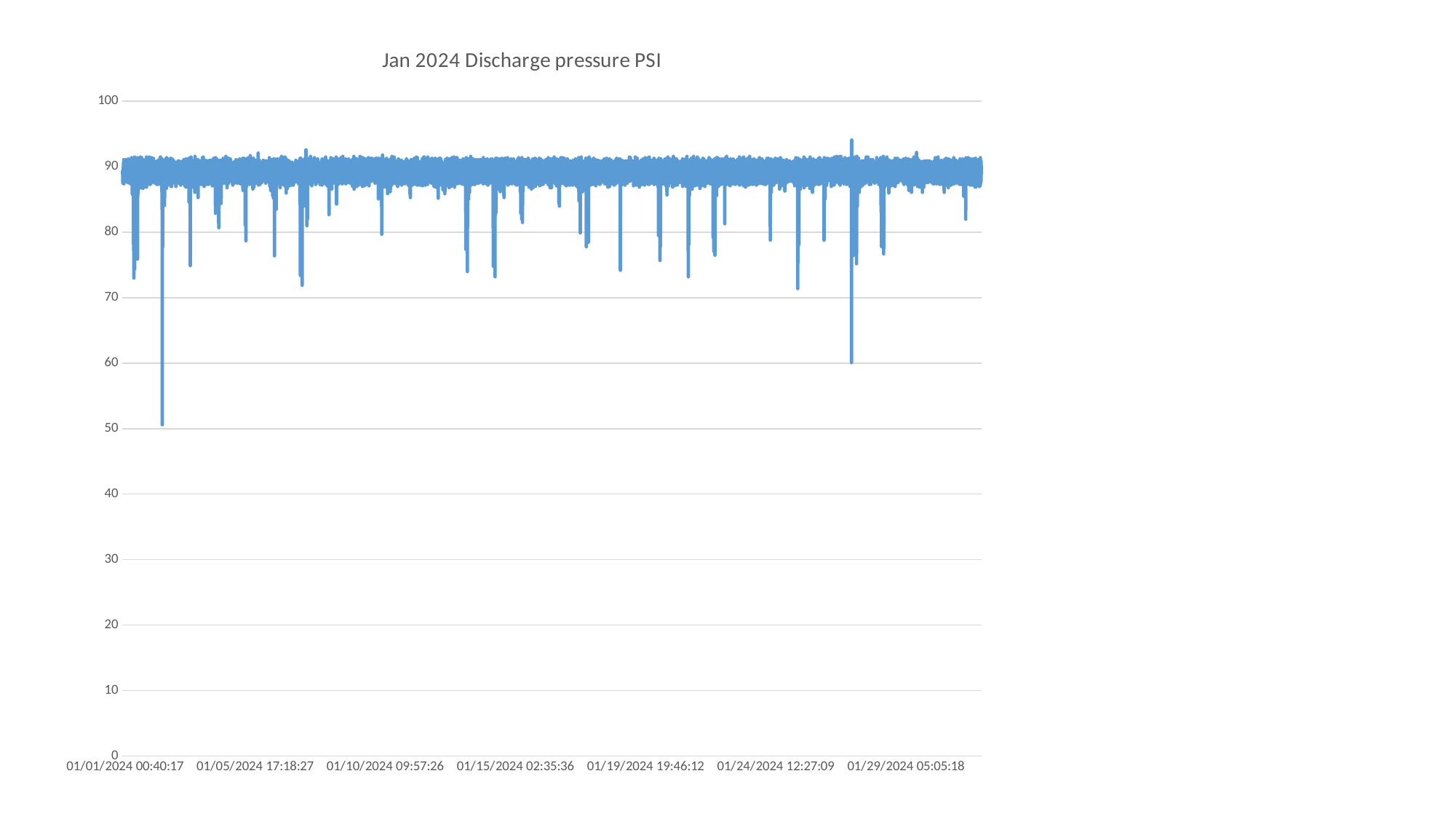
Is the highest value plotted on the chart greater or less than 100? less What kind of chart is shown on the slide? line chart How many date labels are shown along the x axis? 7 Does the baseline level of the line rise, fall, or stay roughly flat from the start to the end of January? roughly flat What is the title of the chart? Jan 2024 Discharge pressure PSI Is the deep dip near 01/29/2024 greater or less than 70? less Is the lowest value plotted on the chart greater or less than 60? less What is the first date label shown on the x axis? 01/01/2024 00:40:17